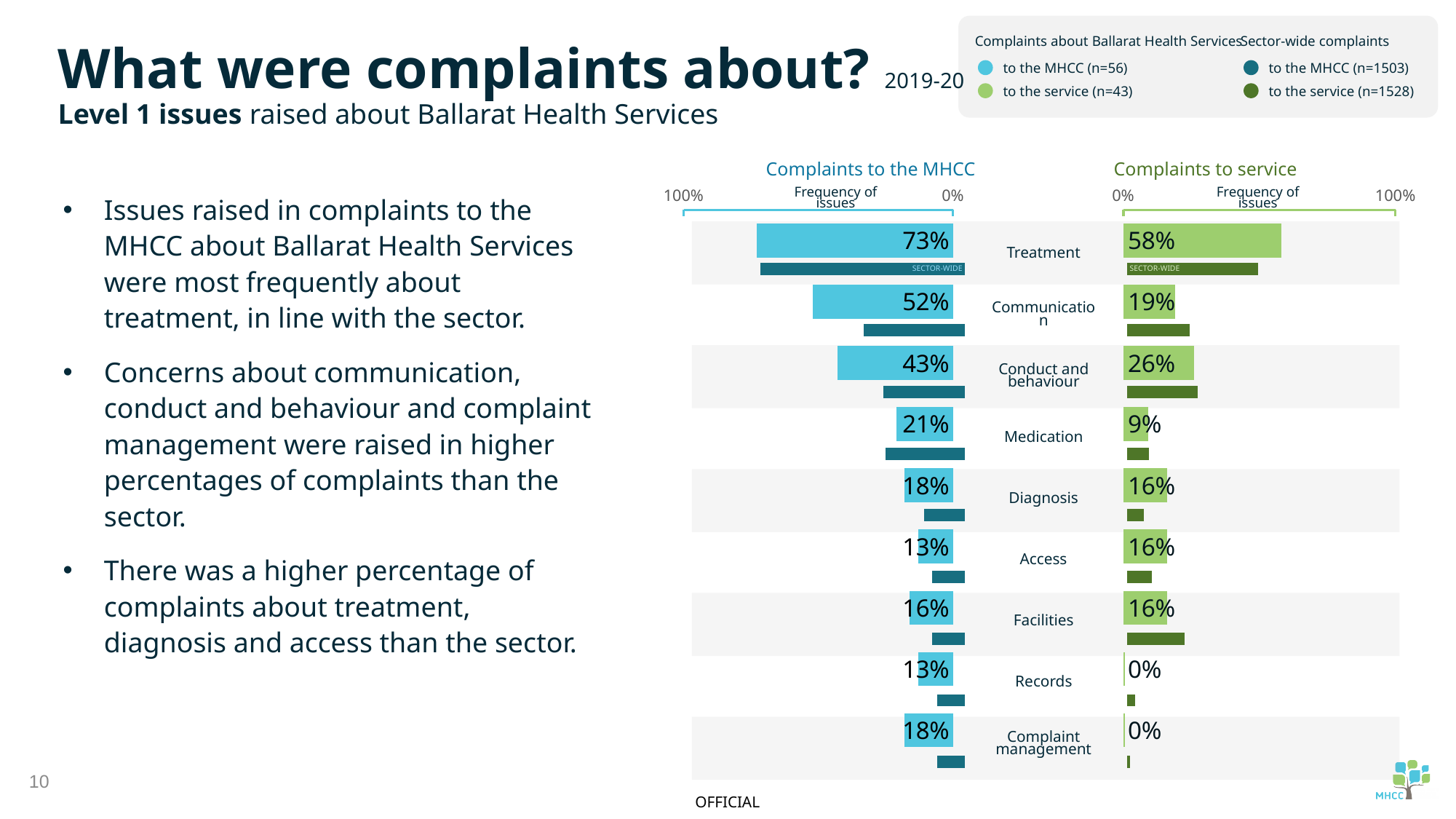
In the Complaints to service chart, what is the value for Records? 0% In the Complaints to service chart, which issue has the highest frequency? Treatment How many entries does the legend at the top right list? 4 In the Complaints to the MHCC chart, what percentage of complaints raised Treatment? 73% Which is larger: the Communication value in the Complaints to the MHCC chart or the Communication value in the Complaints to service chart? Complaints to the MHCC In the Complaints to the MHCC chart, what is the value for Medication? 21% What is the difference between the Treatment value in the Complaints to the MHCC chart and the Treatment value in the Complaints to service chart? 15 percentage points In the Complaints to the MHCC chart, which issue has the highest frequency? Treatment In the Complaints to service chart, what percentage of complaints raised Conduct and behaviour? 26% What type of chart is used to show the frequency of issues? Bar chart How many issue categories are shown in the chart? 9 In the Complaints to the MHCC chart, what is the difference between Communication and Conduct and behaviour? 9 percentage points